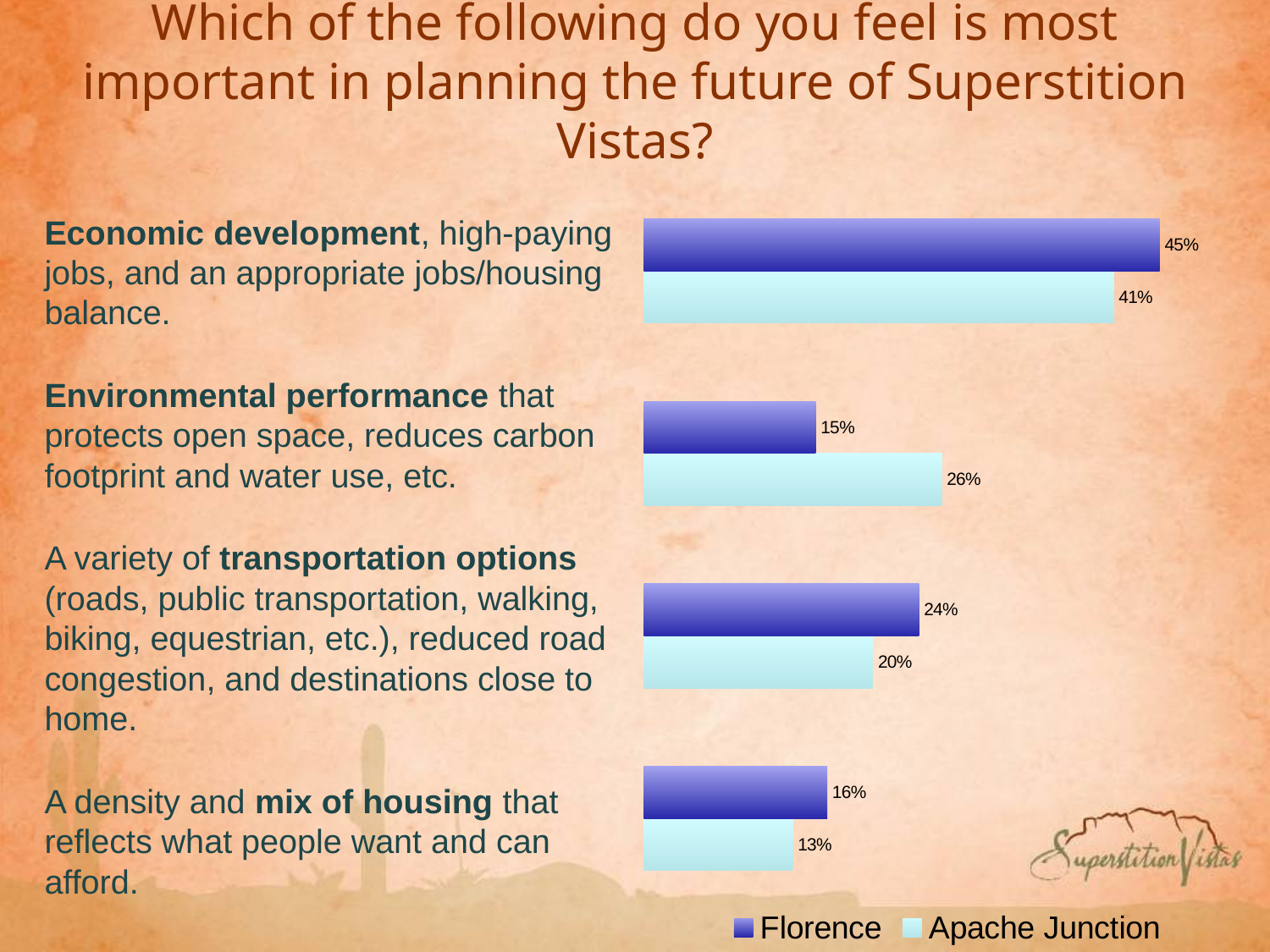
For transportation options, which is larger: the Florence value or the Apache Junction value? Florence What is the difference between the Florence and Apache Junction values for environmental performance? 11% What percentage of Florence respondents chose economic development as most important? 45% Which category has the lowest value for Apache Junction? Mix of housing What is the Florence value for transportation options? 24% How many series does the legend list? 2 Which series is shown in dark blue in the legend? Florence What is the difference between the Florence and Apache Junction values for economic development? 4% What percentage of Apache Junction respondents chose environmental performance? 26% What kind of chart is shown on the slide? Bar chart What is the Apache Junction value for mix of housing? 13% Which category has the highest value for Florence? Economic development